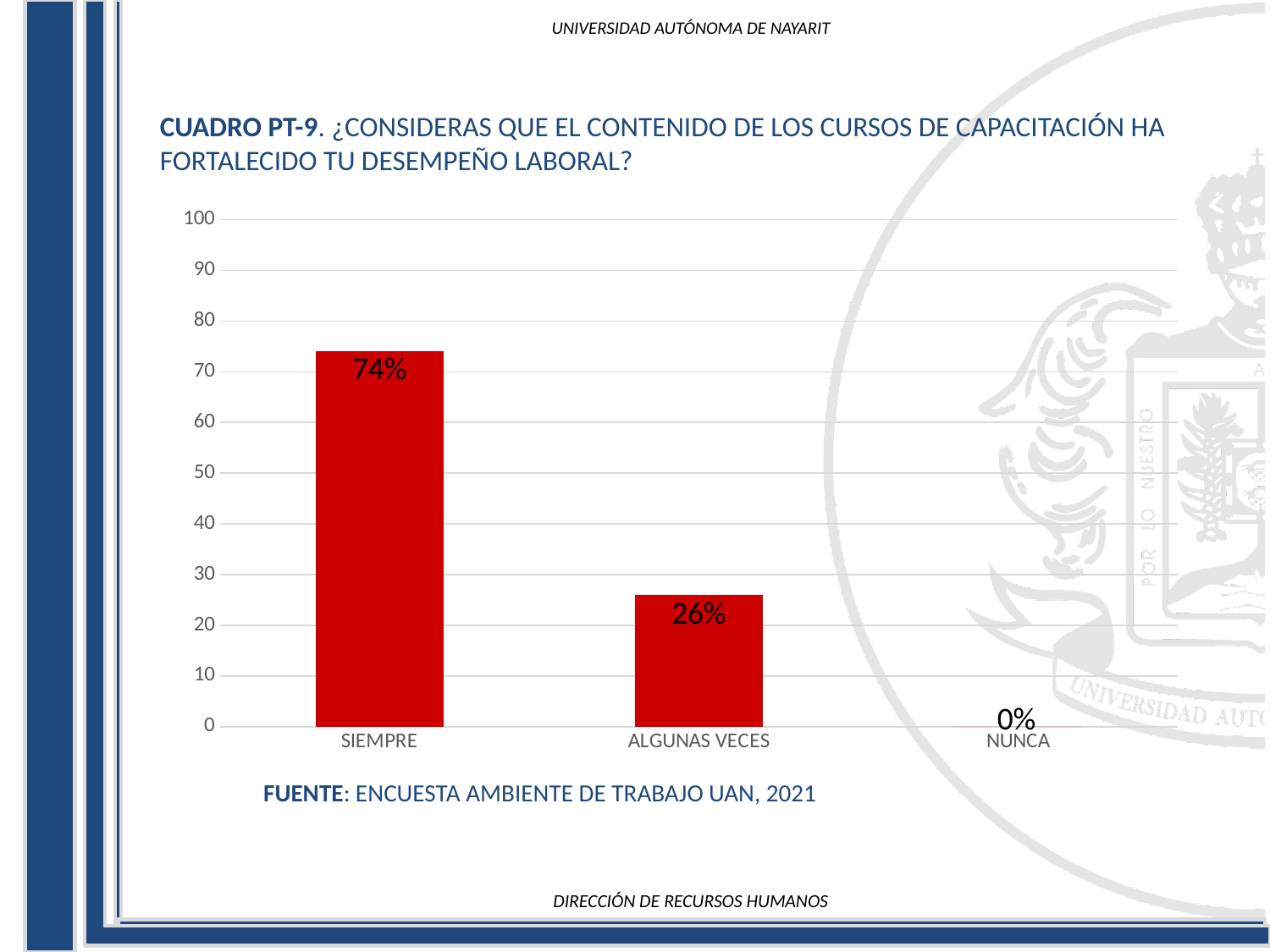
Is the value for ALGUNAS VECES greater or less than 30? less What is the value for NUNCA? 0% Is the value for SIEMPRE greater or less than 70? greater Which category has the lowest value? NUNCA How many categories are shown on the x axis? 3 What is the value for ALGUNAS VECES? 26% Which is larger, the value for SIEMPRE or the value for ALGUNAS VECES? SIEMPRE What source is cited below the chart? ENCUESTA AMBIENTE DE TRABAJO UAN, 2021 What kind of chart is shown on the slide? bar chart What is the value for SIEMPRE? 74% What is the difference between the values for SIEMPRE and ALGUNAS VECES? 48% Which category has the highest value? SIEMPRE